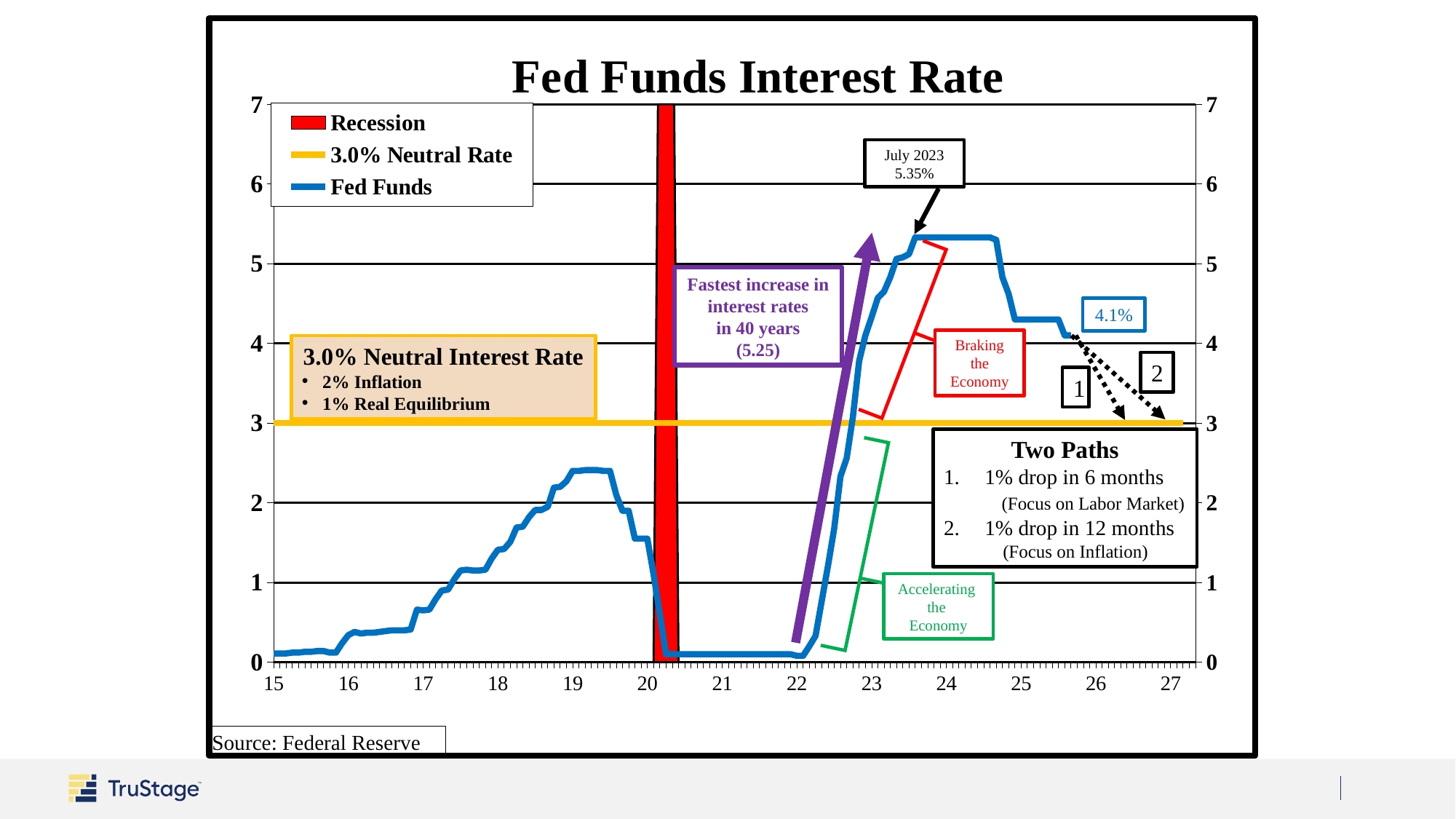
What kind of chart is shown on the slide? line chart Is the Fed Funds rate in 2019 greater or less than 3? less How far above the 3.0% neutral rate is the labeled 4.1% Fed Funds rate? 1.1% How many entries does the chart legend list? 3 Does the Fed Funds rate rise or fall between 2022 and 2023? rise By how much is the July 2023 rate of 5.35% higher than the labeled 4.1% rate? 1.25% What is the most recent Fed Funds rate labeled at the end of the blue line? 4.1% Which is larger, the Fed Funds rate in July 2023 or the labeled 4.1% rate at the end of the line? July 2023 What is the title of the chart? Fed Funds Interest Rate What is the value of the neutral interest rate shown by the yellow line? 3.0% Is the Fed Funds rate in 2021 greater or less than 1? less What Fed Funds rate is labeled for July 2023? 5.35%